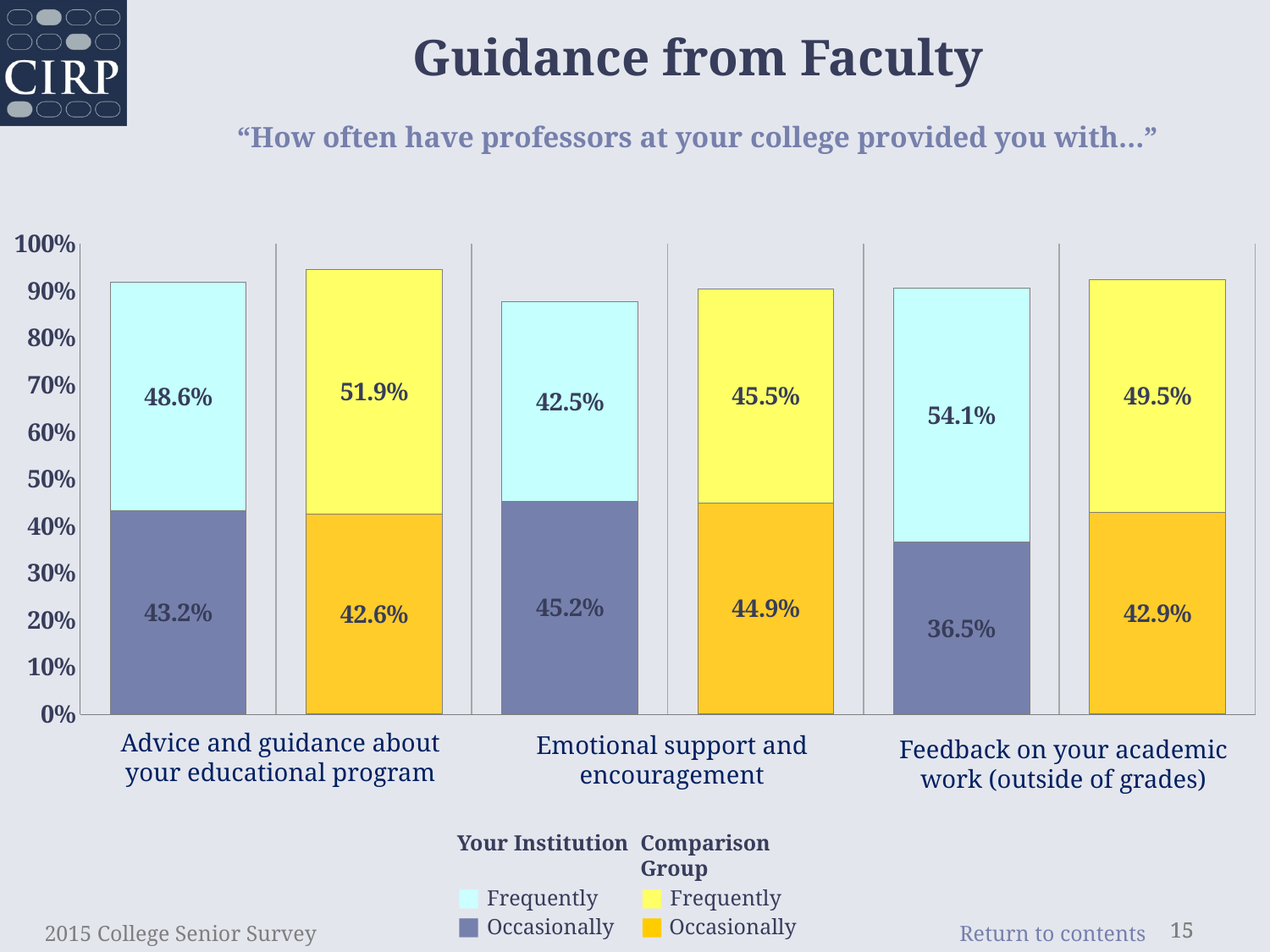
What is the Comparison Group's 'Frequently' value for feedback on your academic work (outside of grades)? 49.5% Which category has the lowest 'Occasionally' value for Your Institution? Feedback on your academic work (outside of grades) What kind of chart is shown on the slide? Stacked bar chart What percentage of students at Your Institution reported that professors frequently provided advice and guidance about their educational program? 48.6% What is the difference between the Comparison Group's and Your Institution's 'Frequently' values for advice and guidance about your educational program? 3.3% What is the total height of the Comparison Group stacked bar for emotional support and encouragement? 90.4% What is the 'Occasionally' value for Your Institution for emotional support and encouragement? 45.2% How many categories are shown on the x axis of the chart? 3 How many series does the legend list? 4 For feedback on your academic work (outside of grades), is the 'Frequently' value higher for Your Institution or the Comparison Group? Your Institution Which category has the highest 'Frequently' value for Your Institution? Feedback on your academic work (outside of grades) What is the total height of the Your Institution stacked bar for advice and guidance about your educational program? 91.8%